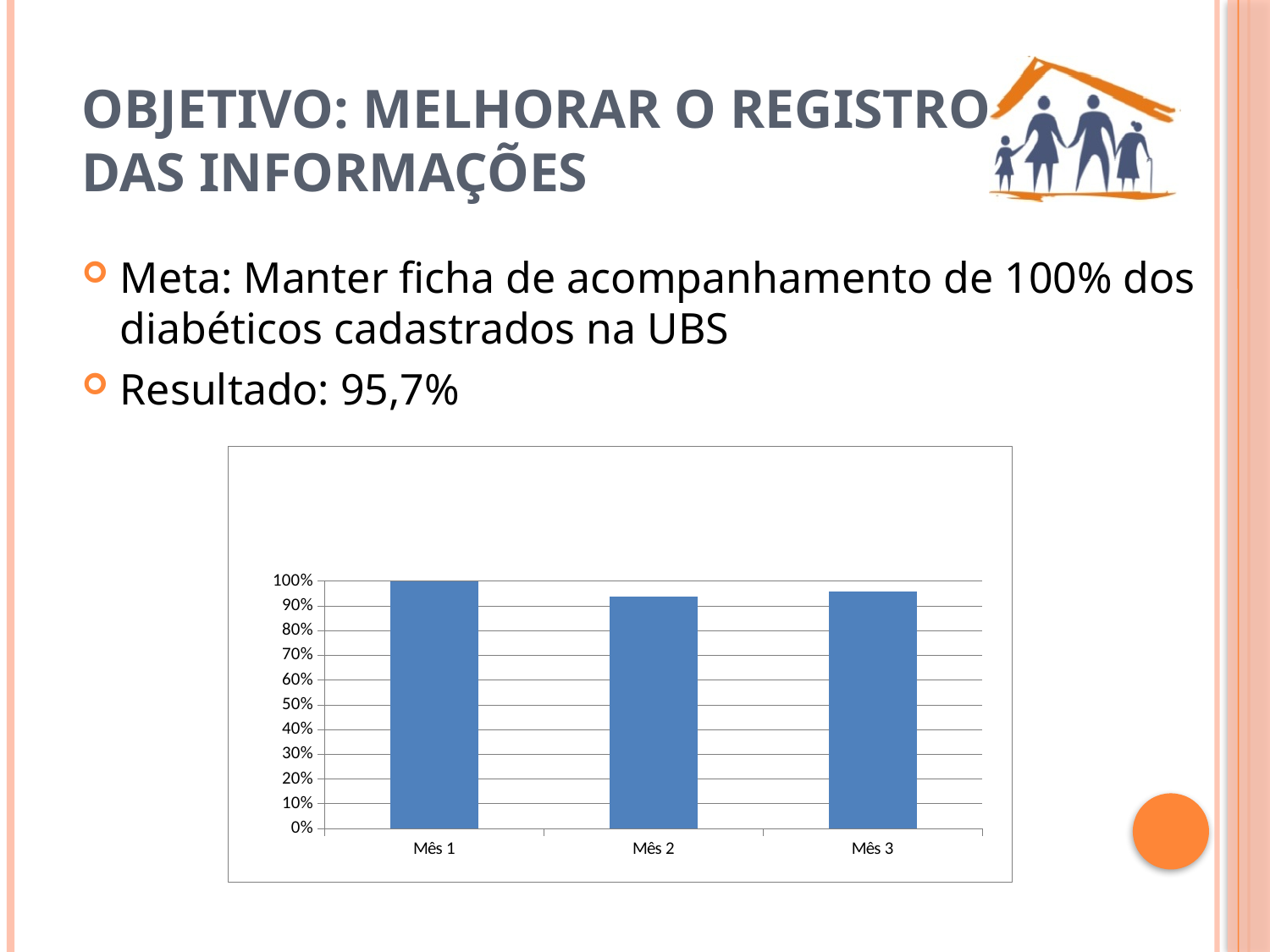
What is the highest value shown on the y axis of the chart? 100% Is the value for Mês 2 greater or less than 90%? greater Which is larger, the value for Mês 1 or the value for Mês 2? Mês 1 Which month has the highest bar in the chart? Mês 1 What is the value for Mês 1 in the chart? 100% Is the value for Mês 2 greater or less than 100%? less Is the value for Mês 3 greater or less than 100%? less How many categories are shown on the x axis of the chart? 3 Which month has the lowest bar in the chart? Mês 2 Does the value fall or rise from Mês 1 to Mês 2? fall What colour are the bars in the chart? Blue What kind of chart is shown on the slide? Bar chart